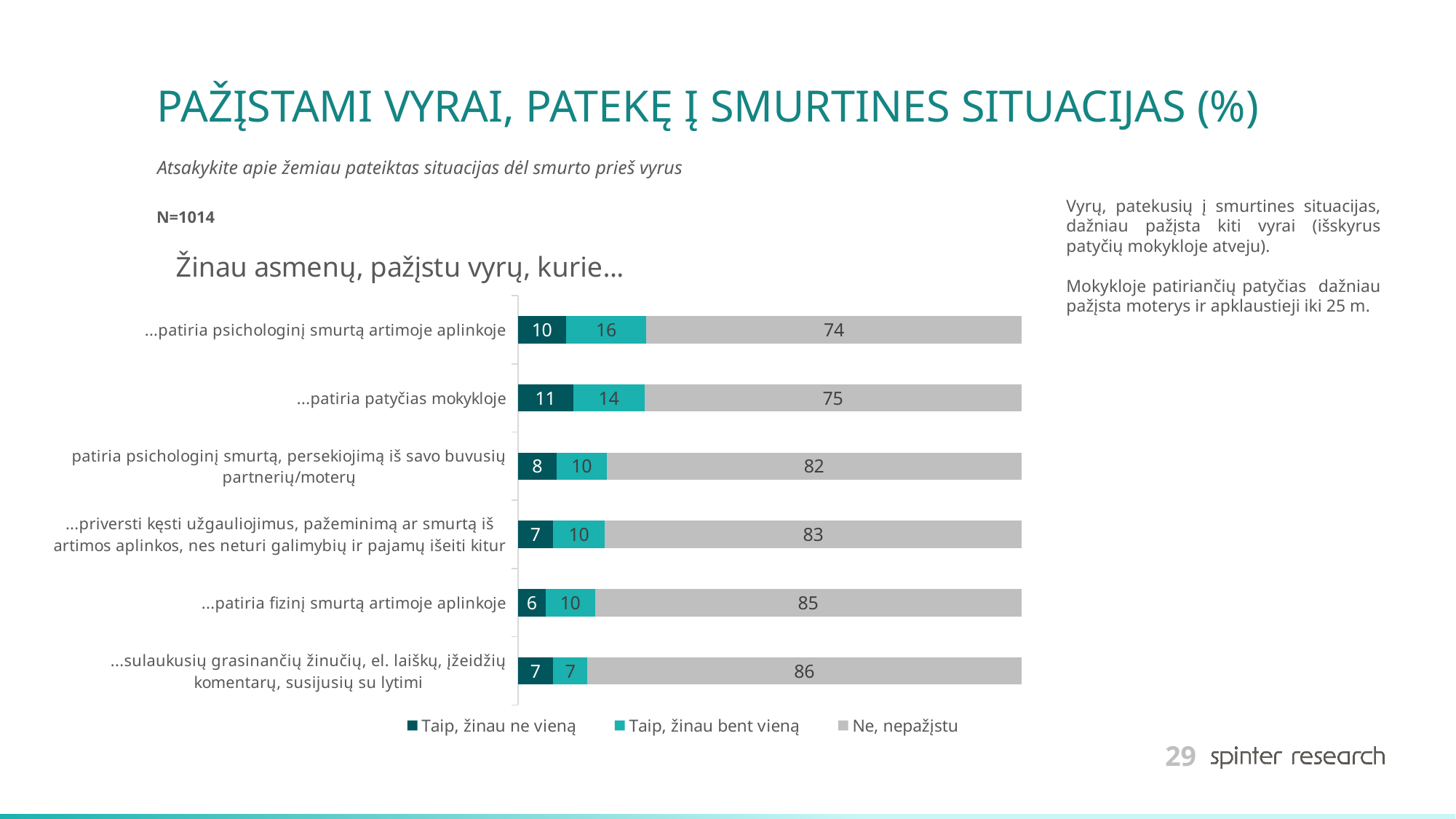
Which is larger: the "Taip, žinau bent vieną" value for "...patiria psichologinį smurtą artimoje aplinkoje" or for "...patiria patyčias mokykloje"? ...patiria psichologinį smurtą artimoje aplinkoje What is the sample size (N) stated on the slide? N=1014 Which category has the highest value for "Taip, žinau ne vieną"? ...patiria patyčias mokykloje What is the value of "Taip, žinau ne vieną" for "...patiria fizinį smurtą artimoje aplinkoje"? 6 What is the total of the stacked bar for "patiria psichologinį smurtą, persekiojimą iš savo buvusių partnerių/moterų"? 100 What type of chart is shown on the slide? Stacked bar chart Which category has the highest value for "Ne, nepažįstu"? ...sulaukusių grasinančių žinučių, el. laiškų, įžeidžių komentarų, susijusių su lytimi What is the value of "Ne, nepažįstu" for "...patiria patyčias mokykloje"? 75 How many categories (situations) are shown in the chart? 6 How many series does the legend list? 3 What is the value of "Taip, žinau bent vieną" for "...patiria psichologinį smurtą artimoje aplinkoje"? 16 What is the difference between the "Ne, nepažįstu" values for "...patiria psichologinį smurtą artimoje aplinkoje" and "...patiria patyčias mokykloje"? 1